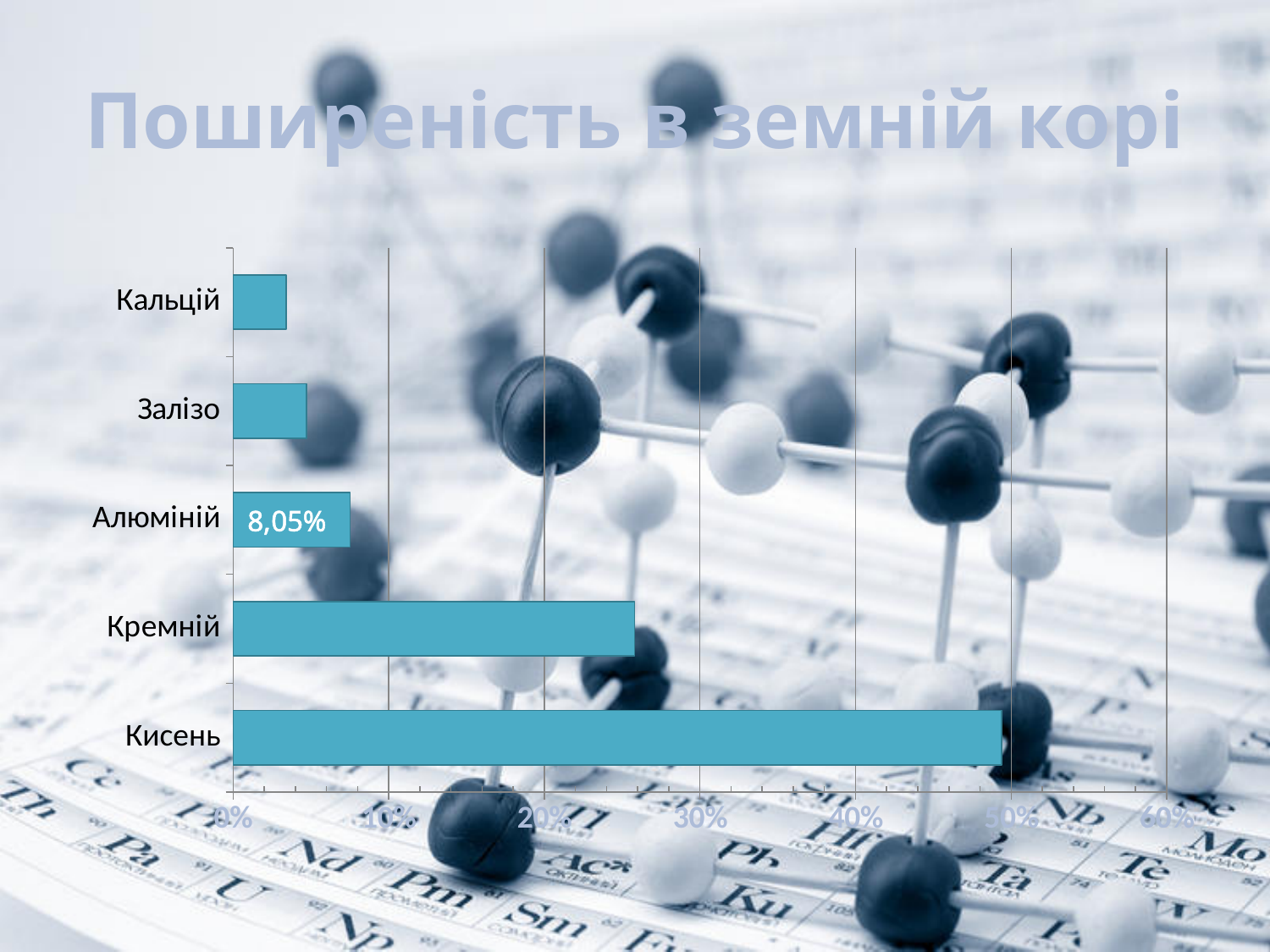
How many categories (elements) are plotted in the chart? 5 Which element has the highest value in the chart? Кисень Which has a larger value, Кремній or Алюміній? Кремній Is the value for Кисень greater or less than 40%? greater Is the value for Залізо greater or less than 10%? less What type of chart is shown on the slide? bar chart What is the value shown for Алюміній? 8,05% What is the title of the chart on the slide? Поширеність в земній корі Which has a larger value, Кисень or Кремній? Кисень Is the value for Кремній greater or less than 20%? greater Which element has the lowest value in the chart? Кальцій